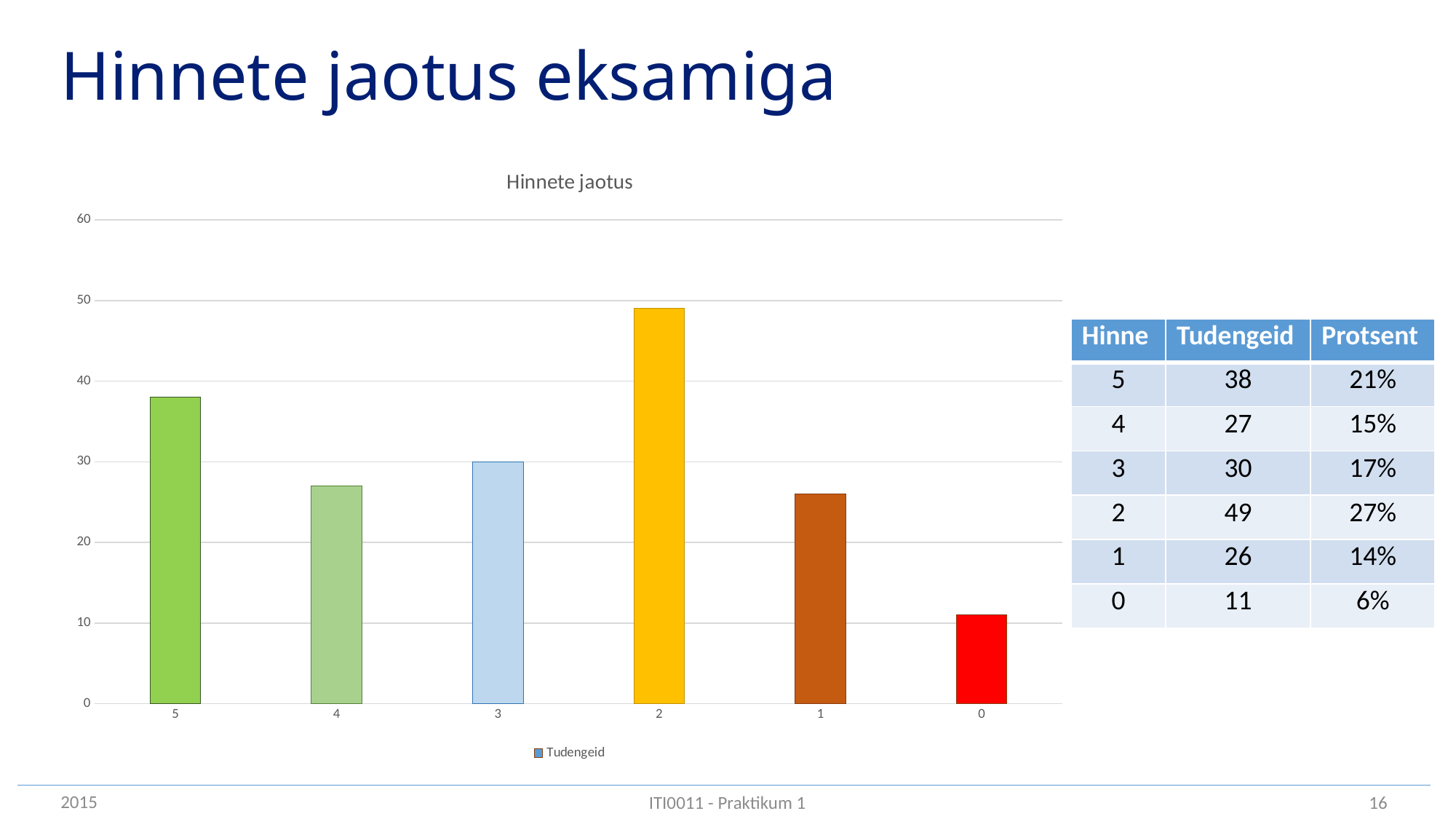
What is the title of the chart? Hinnete jaotus How many categories are shown on the x axis of the chart? 6 How many series does the chart legend list? 1 Which category has the highest bar in the chart? 2 Which is larger in the chart, the value for category 5 or the value for category 4? 5 What is the difference between the values for category 2 and category 1? 23 What kind of chart is shown on the slide? bar chart Is the value for category 5 greater or less than 30? greater What is the value for category 2 in the chart? 49 Is the value for category 0 greater or less than 20? less What is the value for category 3 in the chart? 30 Which category has the lowest bar in the chart? 0